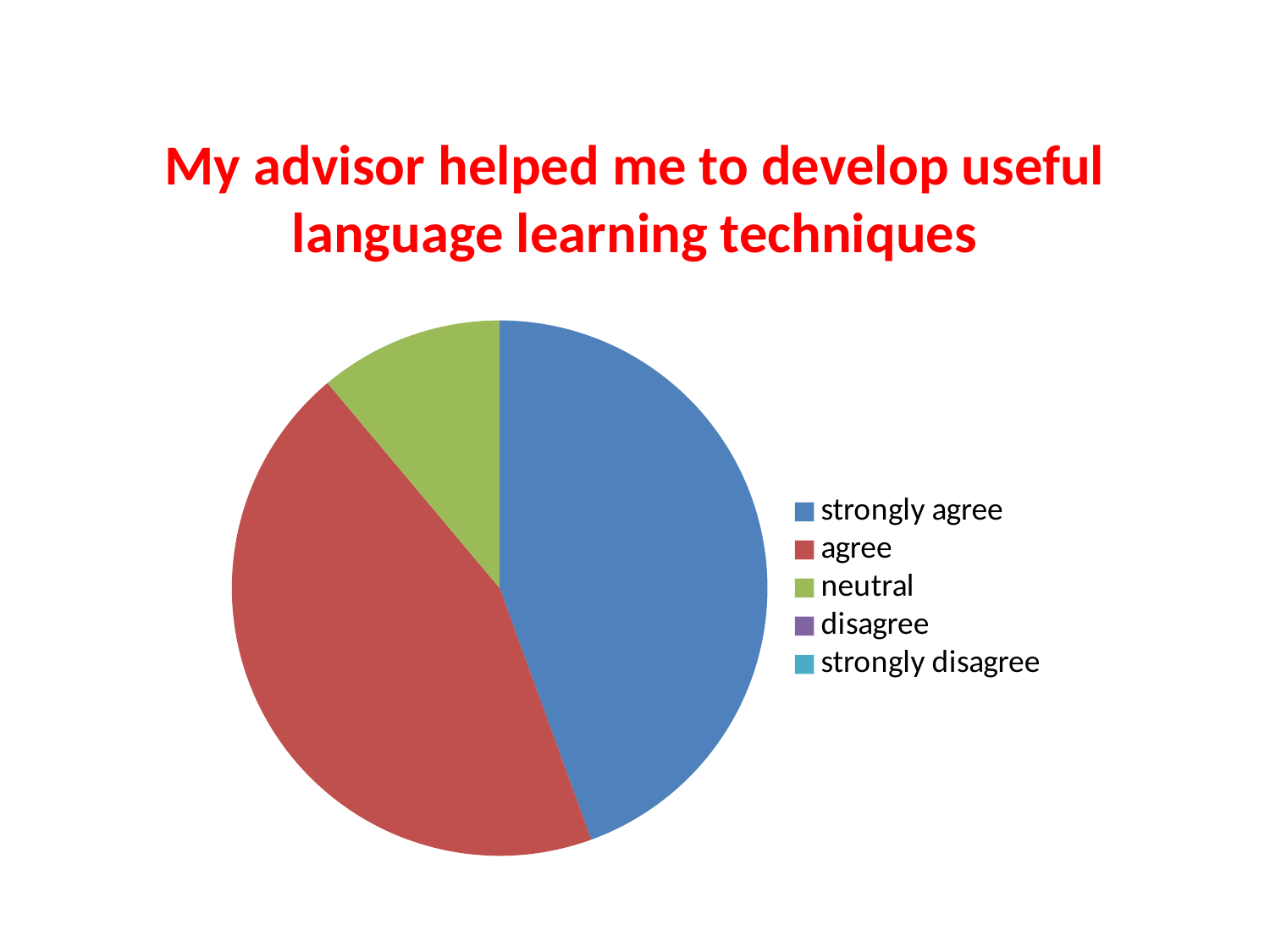
Which is larger, the slice for agree or the slice for neutral? agree How many entries does the legend list? 5 How many slices are visible in the pie chart? 3 What kind of chart is shown on the slide? pie chart What is the title of the chart? My advisor helped me to develop useful language learning techniques What colour is the slice for agree? red Which is larger, the slice for strongly agree or the slice for neutral? strongly agree Of the visible slices, which category has the smallest slice? neutral